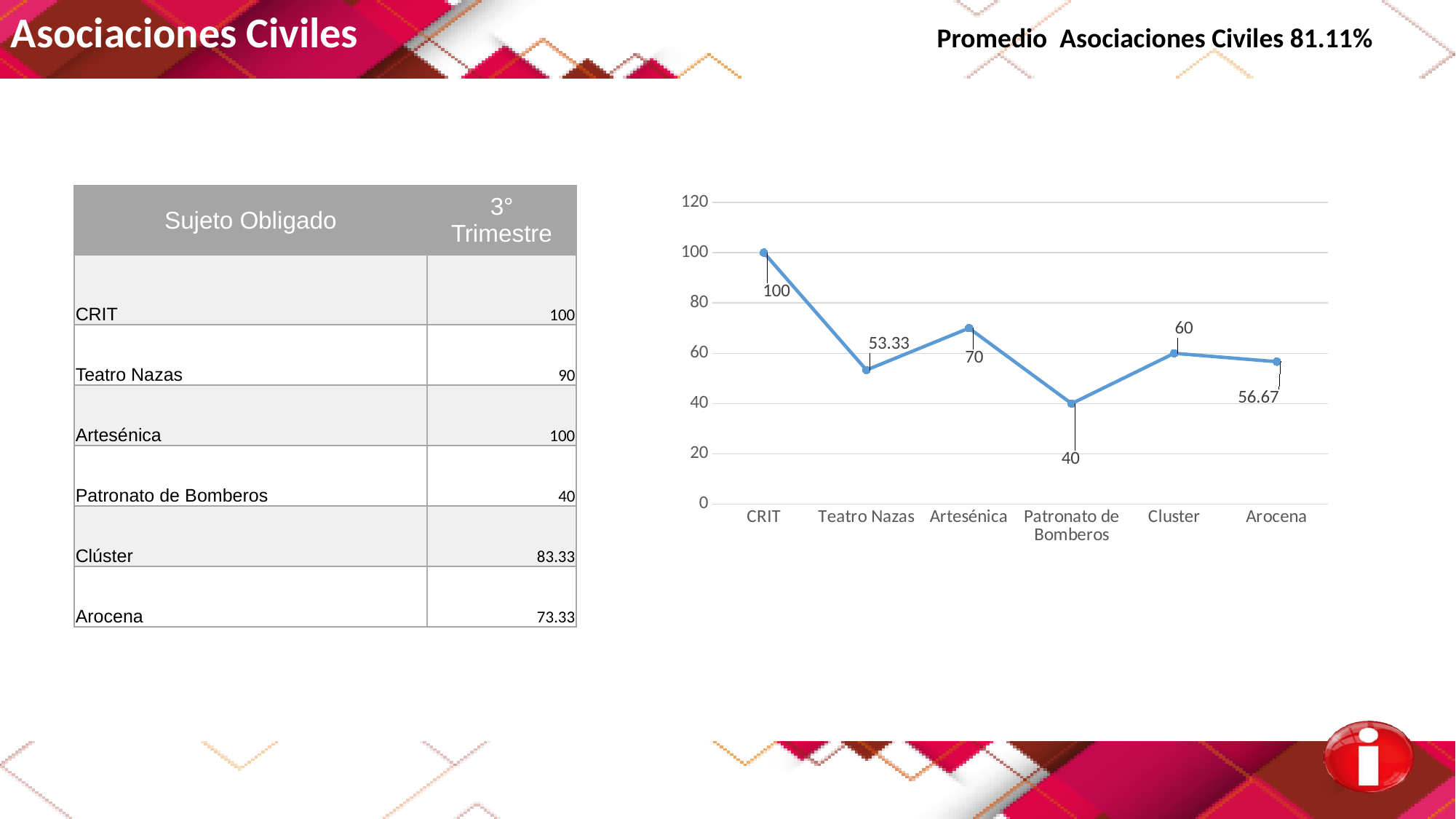
Which category has the highest value in the chart? CRIT In the chart, what is the value for Patronato de Bomberos? 40 In the chart, what is the difference between the values for CRIT and Patronato de Bomberos? 60 How many categories are plotted on the x axis of the chart? 6 In the chart, what is the value for Artesénica? 70 In the chart, which is larger, the value for Artesénica or the value for Cluster? Artesénica In the chart, what is the value for Arocena? 56.67 In the chart, is the value for Cluster greater or less than 80? less In the chart, what is the value for CRIT? 100 Which category has the lowest value in the chart? Patronato de Bomberos In the chart, what is the value for Teatro Nazas? 53.33 What type of chart is shown on the slide? line chart